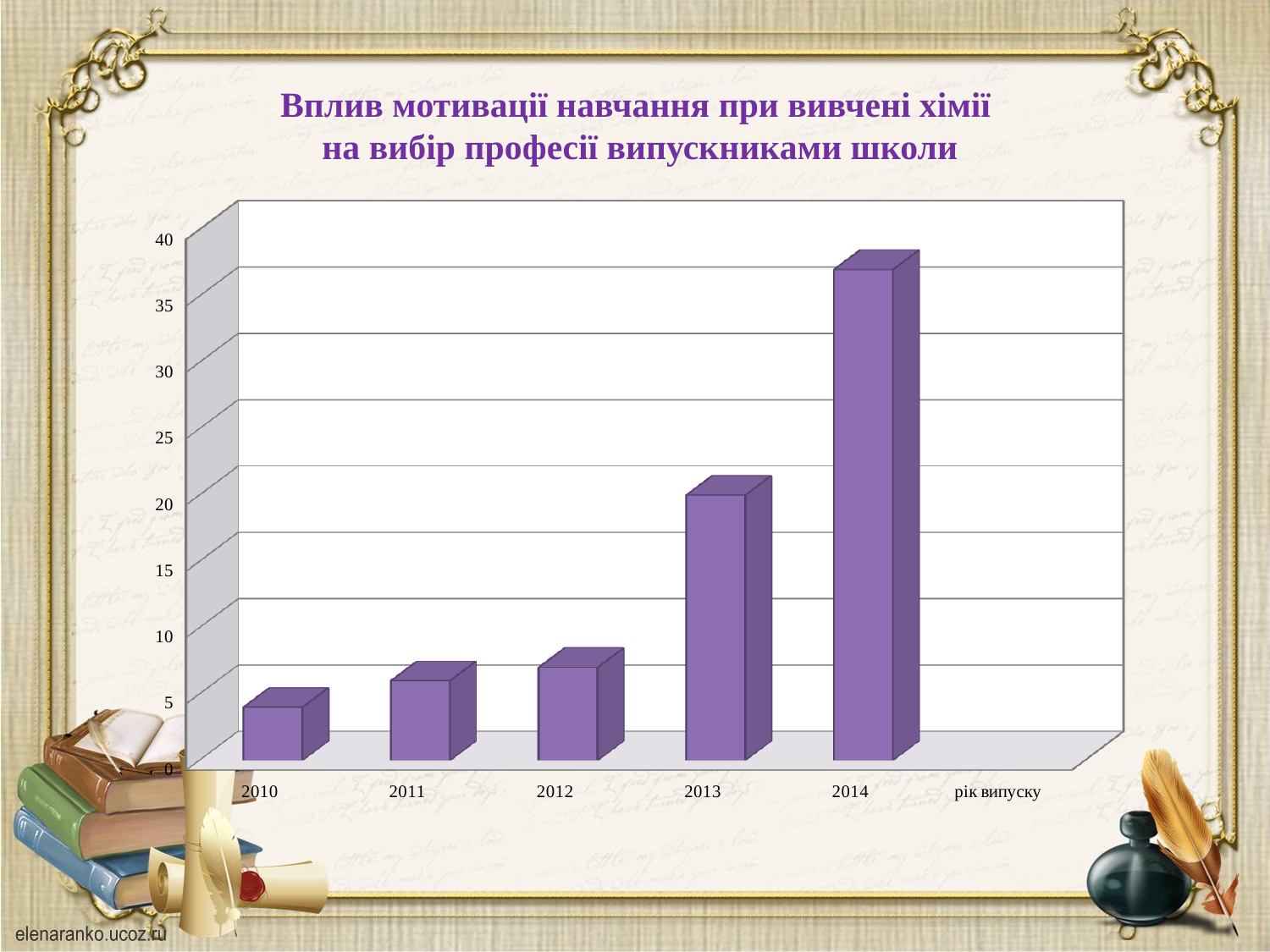
What kind of chart is shown on the slide? bar chart Do the values rise or fall from 2010 to 2014? rise Is the value for 2013 greater or less than 15? greater What is the label shown on the x axis of the chart? рік випуску Which year has the highest bar? 2014 Which year has the lowest bar? 2010 Is the value for 2010 greater or less than 10? less Is the value for 2012 greater or less than 10? less How many years (categories) are plotted on the chart? 5 Which is larger, the value for 2013 or the value for 2012? 2013